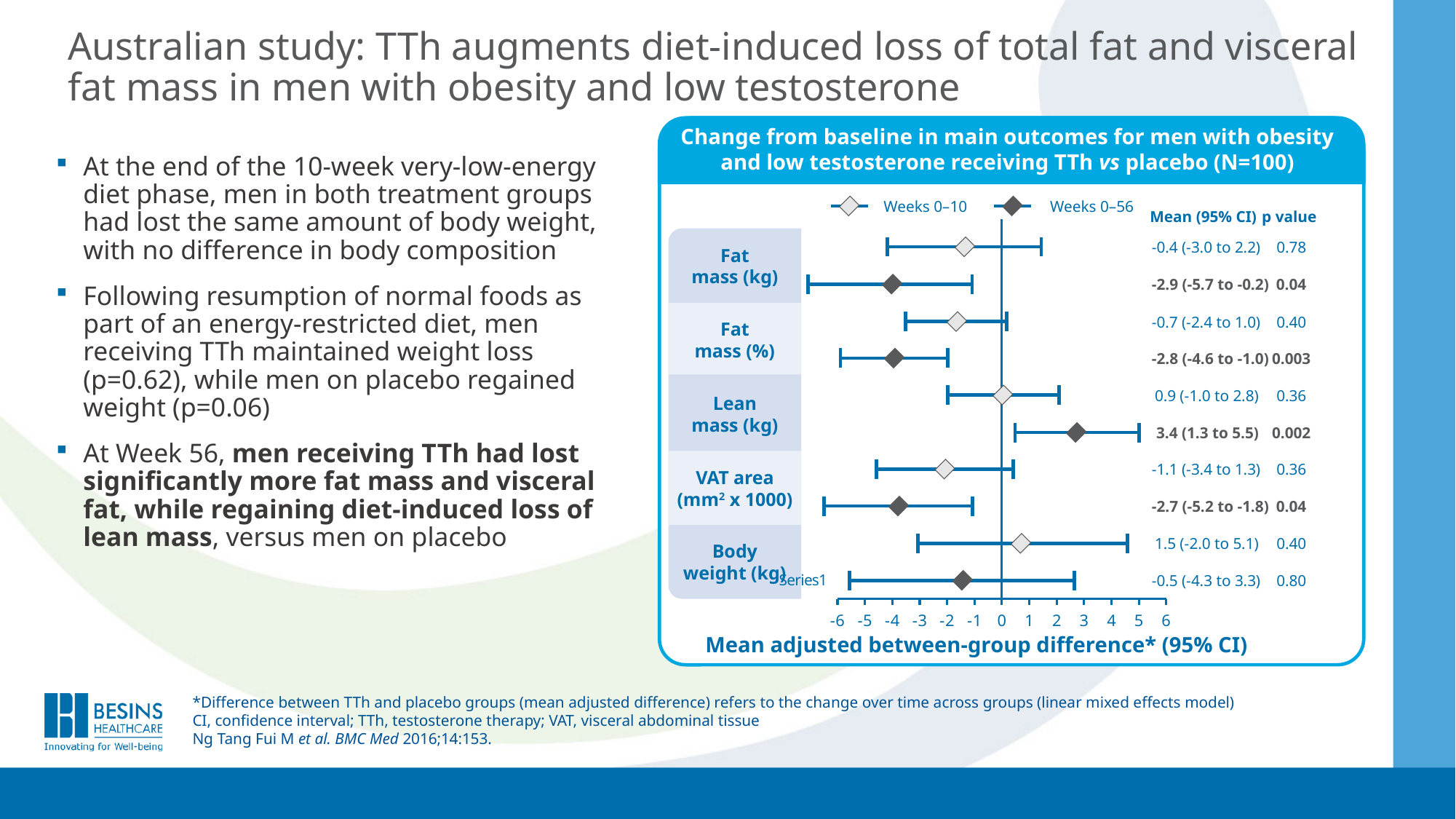
How many series does the chart legend list? 2 What is the mean adjusted between-group difference for Body weight (kg) at Weeks 0–10? 1.5 Which outcome has the lowest mean adjusted between-group difference at Weeks 0–56? Fat mass (kg) Which outcome has the highest mean adjusted between-group difference at Weeks 0–56? Lean mass (kg) What is the 95% CI for VAT area (mm² x 1000) at Weeks 0–56? -5.2 to -1.8 How many outcome categories are plotted in the chart? 5 What is the mean adjusted between-group difference for Fat mass (kg) at Weeks 0–56? -2.9 What is the p value for Fat mass (%) at Weeks 0–56? 0.003 What is the difference between the Weeks 0–56 and Weeks 0–10 mean values for Lean mass (kg)? 2.5 What is the x-axis label of the chart? Mean adjusted between-group difference* (95% CI) Which is larger, the Weeks 0–10 mean for Body weight (kg) or the Weeks 0–56 mean for Body weight (kg)? Weeks 0–10 What is the p value for Lean mass (kg) at Weeks 0–56? 0.002